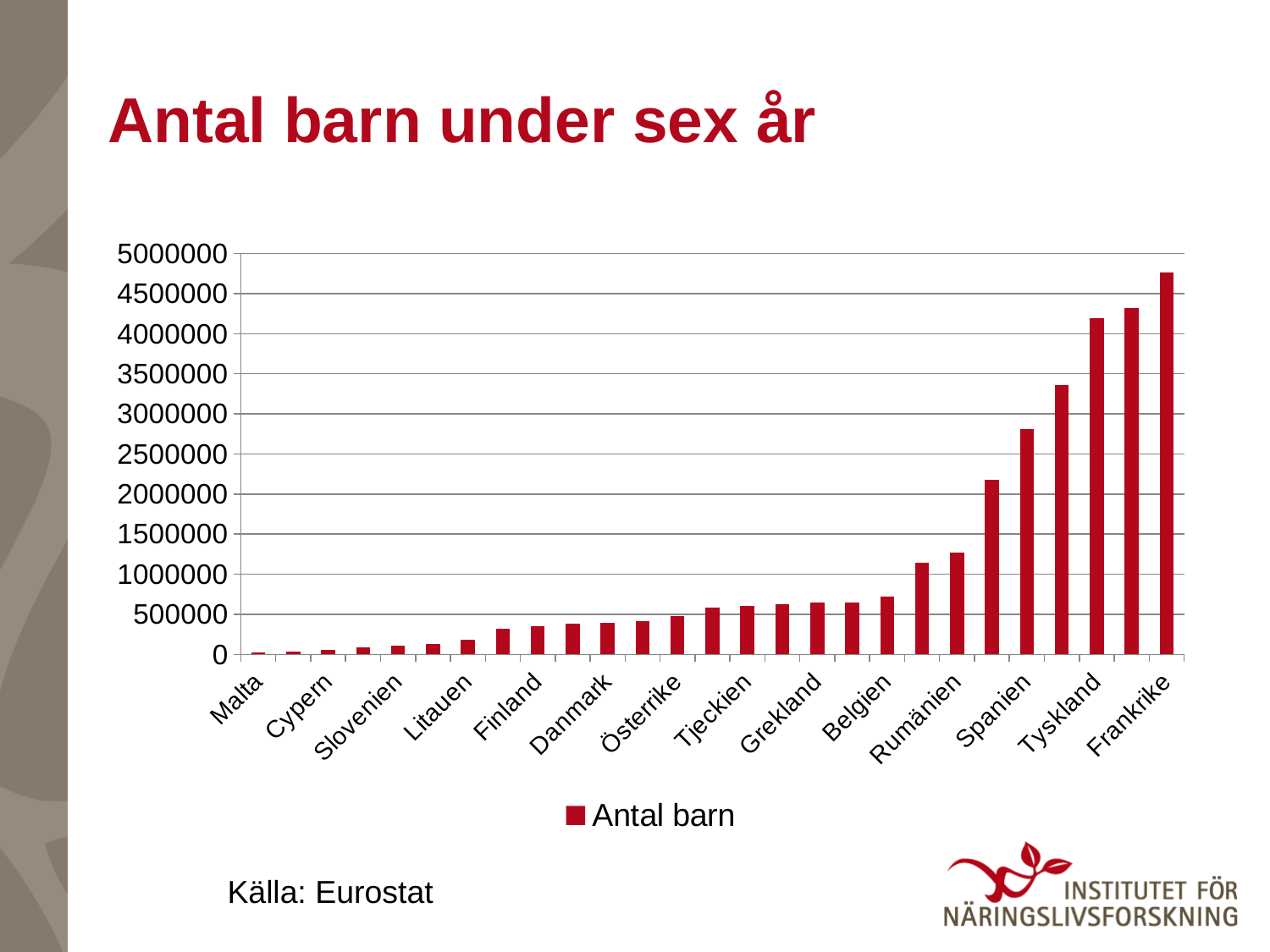
Which country has the highest number of children under six years? Frankrike Is the value for Rumänien greater or less than 1000000? greater What type of chart is shown on the slide? Bar chart Which has a larger value, Spanien or Rumänien? Spanien Is the value for Spanien greater or less than 2500000? greater How many series does the legend list? 1 Do the values rise or fall from left to right along the x axis? rise Is the value for Finland greater or less than 500000? less Which has a larger value, Frankrike or Tyskland? Frankrike Which country has the lowest number of children under six years? Malta